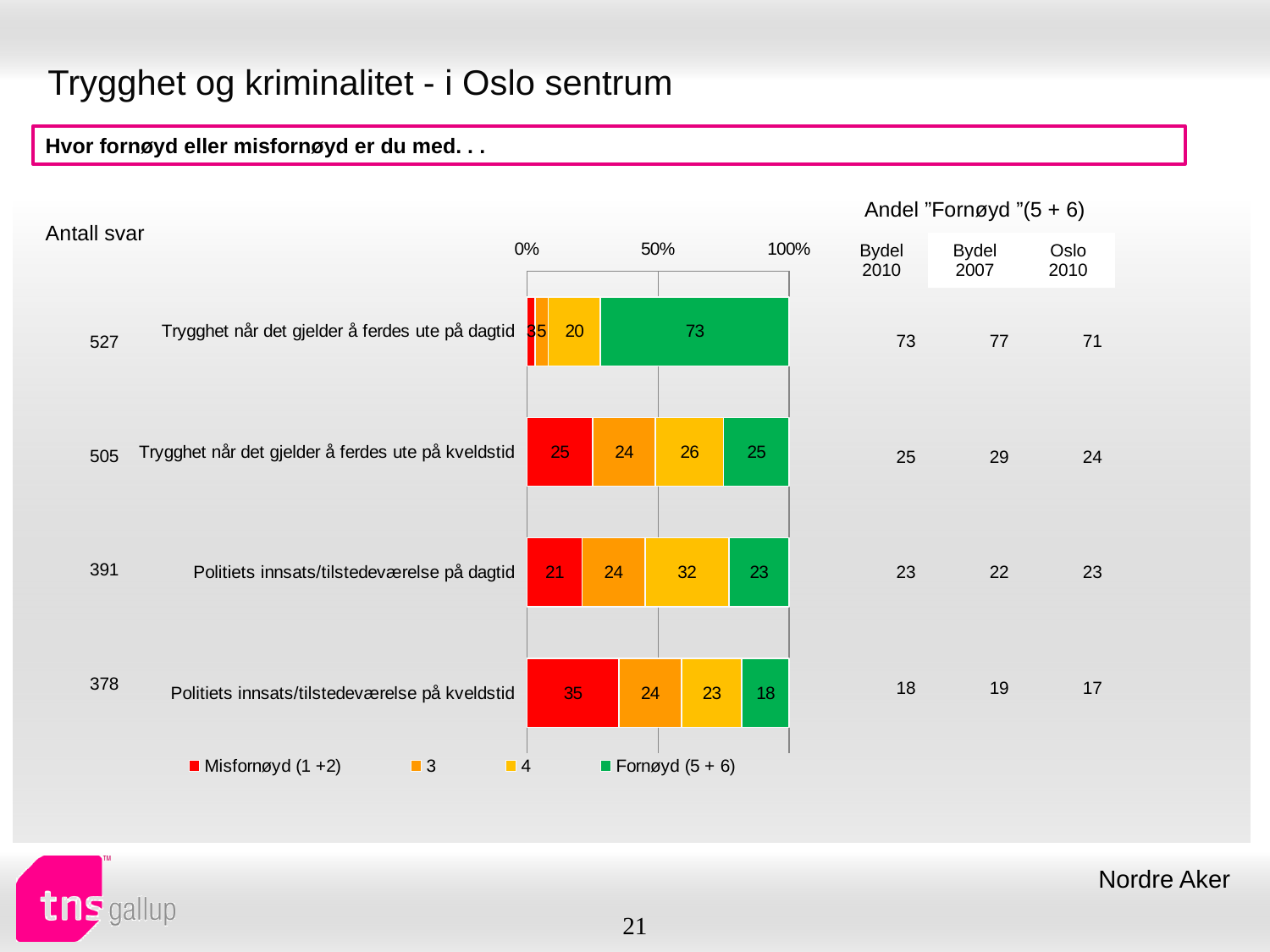
What is the value of the Fornøyd (5 + 6) segment for "Trygghet når det gjelder å ferdes ute på dagtid"? 73 How many categories are shown in the bar chart? 4 What is the value of the Misfornøyd (1 +2) segment for "Politiets innsats/tilstedeværelse på kveldstid"? 35 What kind of chart is shown on the slide? Stacked bar chart What is the total of the stacked bar for "Politiets innsats/tilstedeværelse på kveldstid"? 100 Which has the larger Misfornøyd (1 +2) value: "Politiets innsats/tilstedeværelse på kveldstid" or "Trygghet når det gjelder å ferdes ute på kveldstid"? Politiets innsats/tilstedeværelse på kveldstid What is the difference between the Fornøyd (5 + 6) values for "Trygghet når det gjelder å ferdes ute på dagtid" and "Trygghet når det gjelder å ferdes ute på kveldstid"? 48 Is the Fornøyd (5 + 6) value for "Trygghet når det gjelder å ferdes ute på dagtid" greater or less than 50%? greater How many series does the legend list? 4 Which category has the highest Fornøyd (5 + 6) value? Trygghet når det gjelder å ferdes ute på dagtid What is the value of the "4" segment for "Politiets innsats/tilstedeværelse på dagtid"? 32 Which category has the lowest Fornøyd (5 + 6) value? Politiets innsats/tilstedeværelse på kveldstid